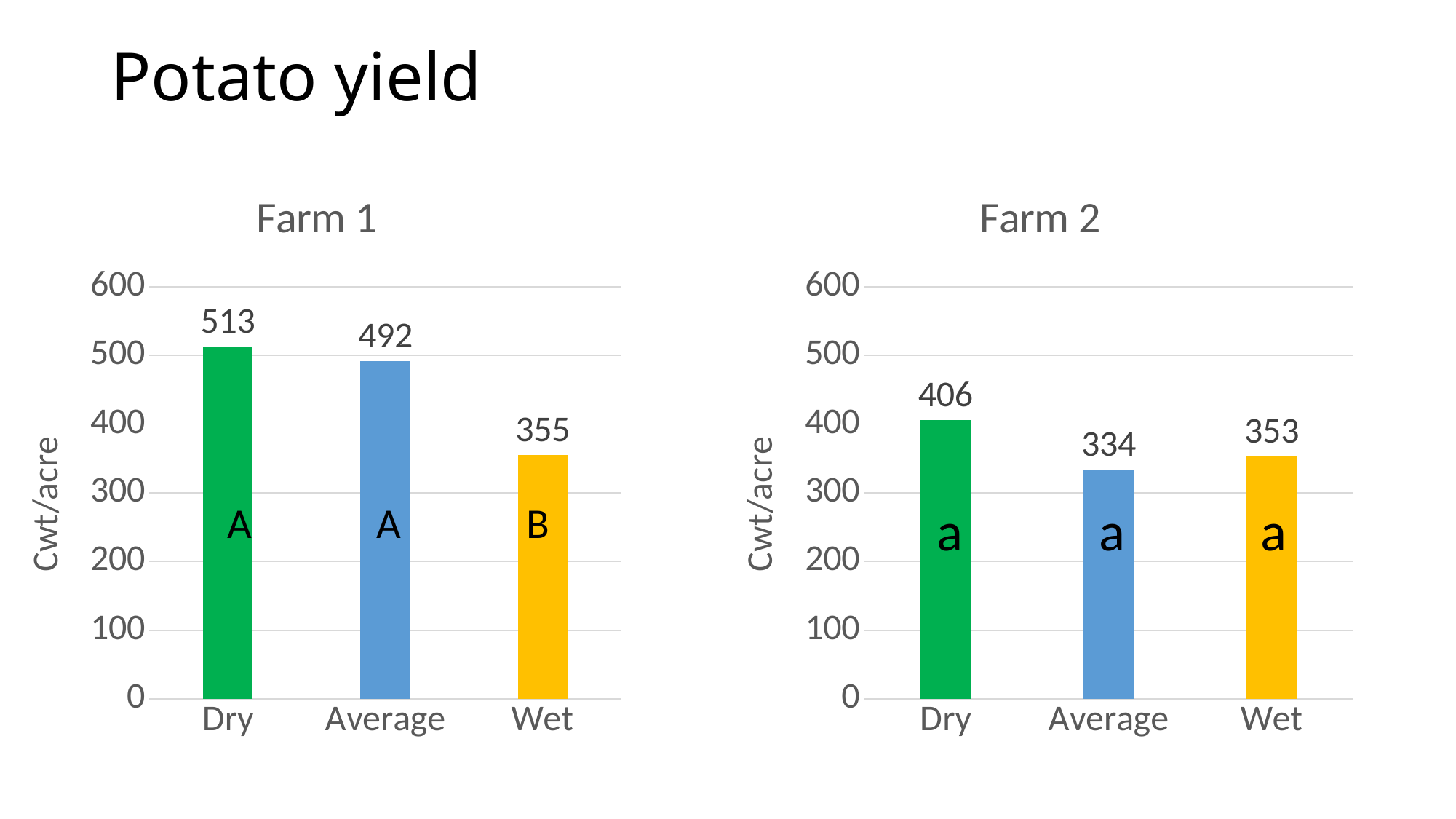
In the Farm 2 chart, which category has the highest value? Dry In the Farm 1 chart, do the values rise or fall from Dry to Wet? fall How many categories are shown in the Farm 1 chart? 3 In the Farm 2 chart, is the value for Dry greater or less than 400? greater In the Farm 1 chart, what is the difference between the Dry and Wet values? 158 In the Farm 2 chart, what is the value for Average? 334 What is the y-axis label on the Farm 1 chart? Cwt/acre In the Farm 1 chart, what is the value for Dry? 513 In the Farm 2 chart, what is the difference between the Dry and Average values? 72 What kind of chart is the Farm 2 chart? bar chart In the Farm 1 chart, which category has the lowest value? Wet In the Farm 1 chart, which is larger, the value for Average or the value for Wet? Average